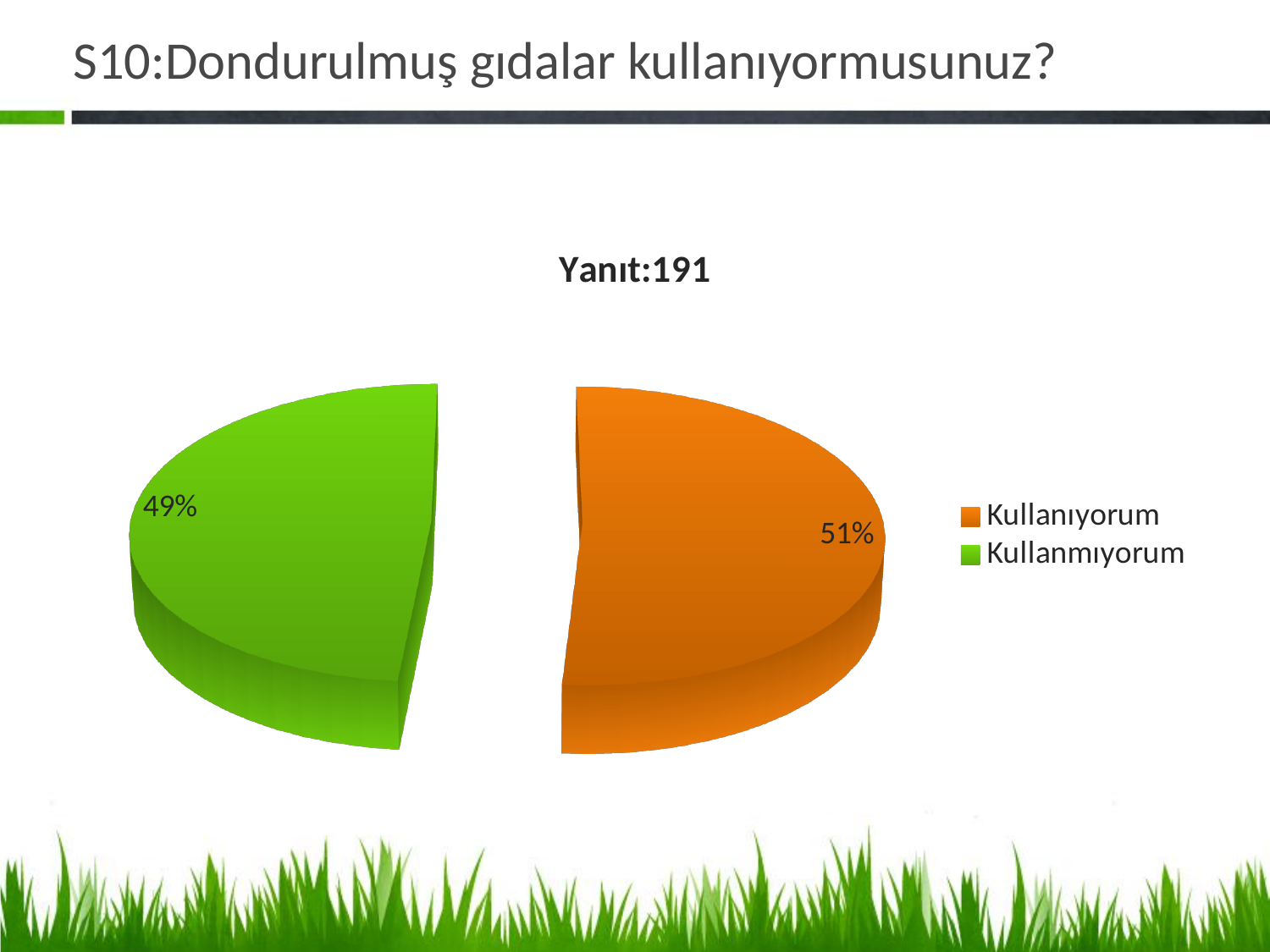
Which is larger, the Kullanıyorum slice or the Kullanmıyorum slice? Kullanıyorum What percentage of the pie is labelled Kullanıyorum? 51% What percentage of the pie is labelled Kullanmıyorum? 49% How many entries does the legend list? 2 How many slices does the pie chart have? 2 What colour is the Kullanmıyorum slice? green What is the difference in percentage points between the Kullanıyorum and Kullanmıyorum slices? 2% What share of the pie does the Kullanıyorum slice represent? 51% What kind of chart is shown on the slide? pie chart What is the chart's title? Yanıt:191 Which slice is the smallest in the pie chart? Kullanmıyorum Which slice is the largest in the pie chart? Kullanıyorum